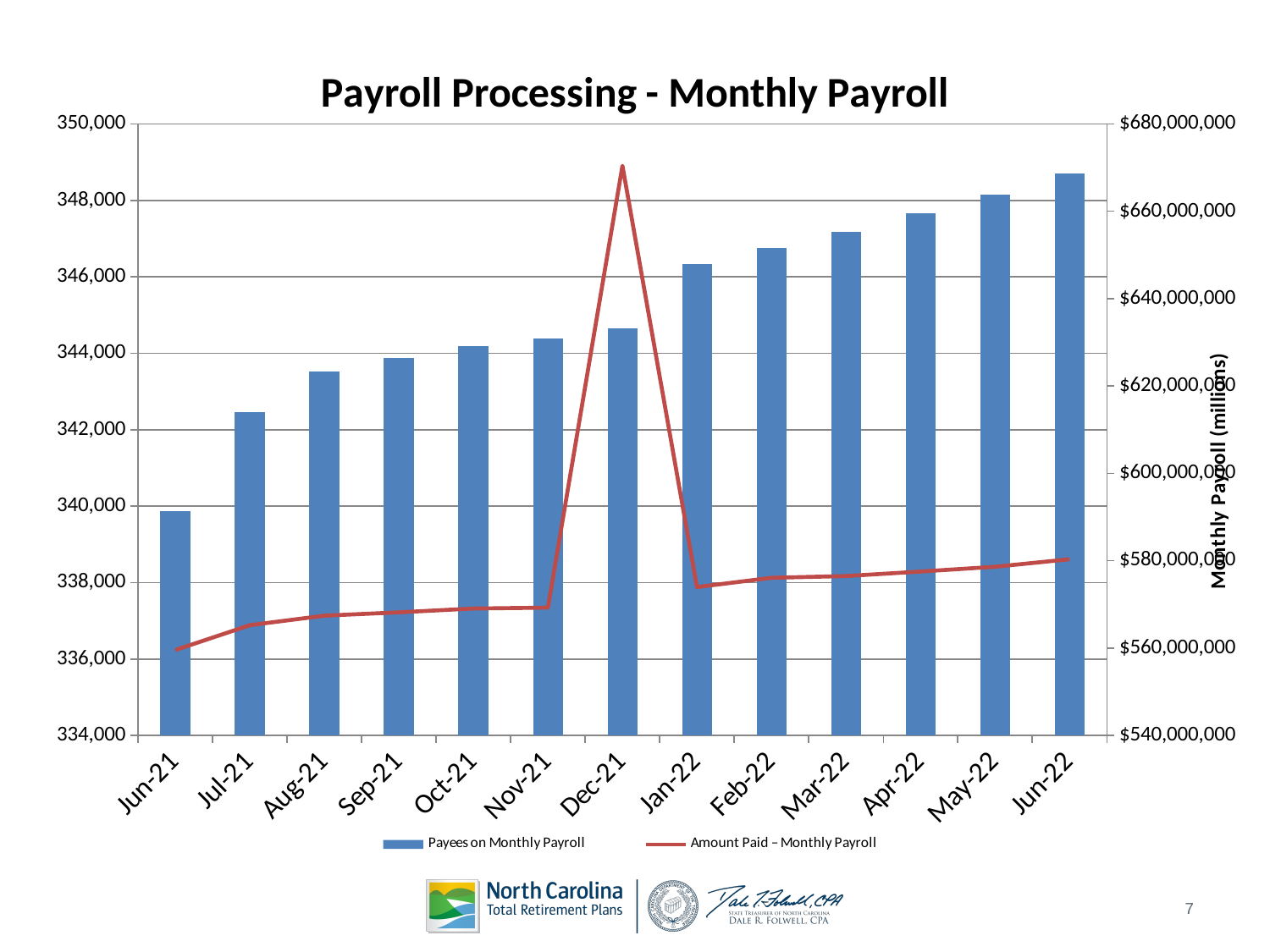
Do the Payees on Monthly Payroll bars rise or fall from Jun-21 to Jun-22? Rise In which month does the Amount Paid – Monthly Payroll line reach its peak? Dec-21 Is the number of Payees on Monthly Payroll for Jun-22 greater or less than 348,000? greater Is the Amount Paid – Monthly Payroll value for Dec-21 greater or less than $660,000,000? greater Which month has the lowest number of Payees on Monthly Payroll? Jun-21 How many series does the legend list? 2 How many months are plotted along the x axis? 13 What kind of chart is shown on the slide? Combination bar and line chart Is the Amount Paid – Monthly Payroll value for Jan-22 greater or less than $580,000,000? less What is the title of the chart? Payroll Processing - Monthly Payroll Which month has more Payees on Monthly Payroll, Dec-21 or Jan-22? Jan-22 Which month has the highest number of Payees on Monthly Payroll? Jun-22